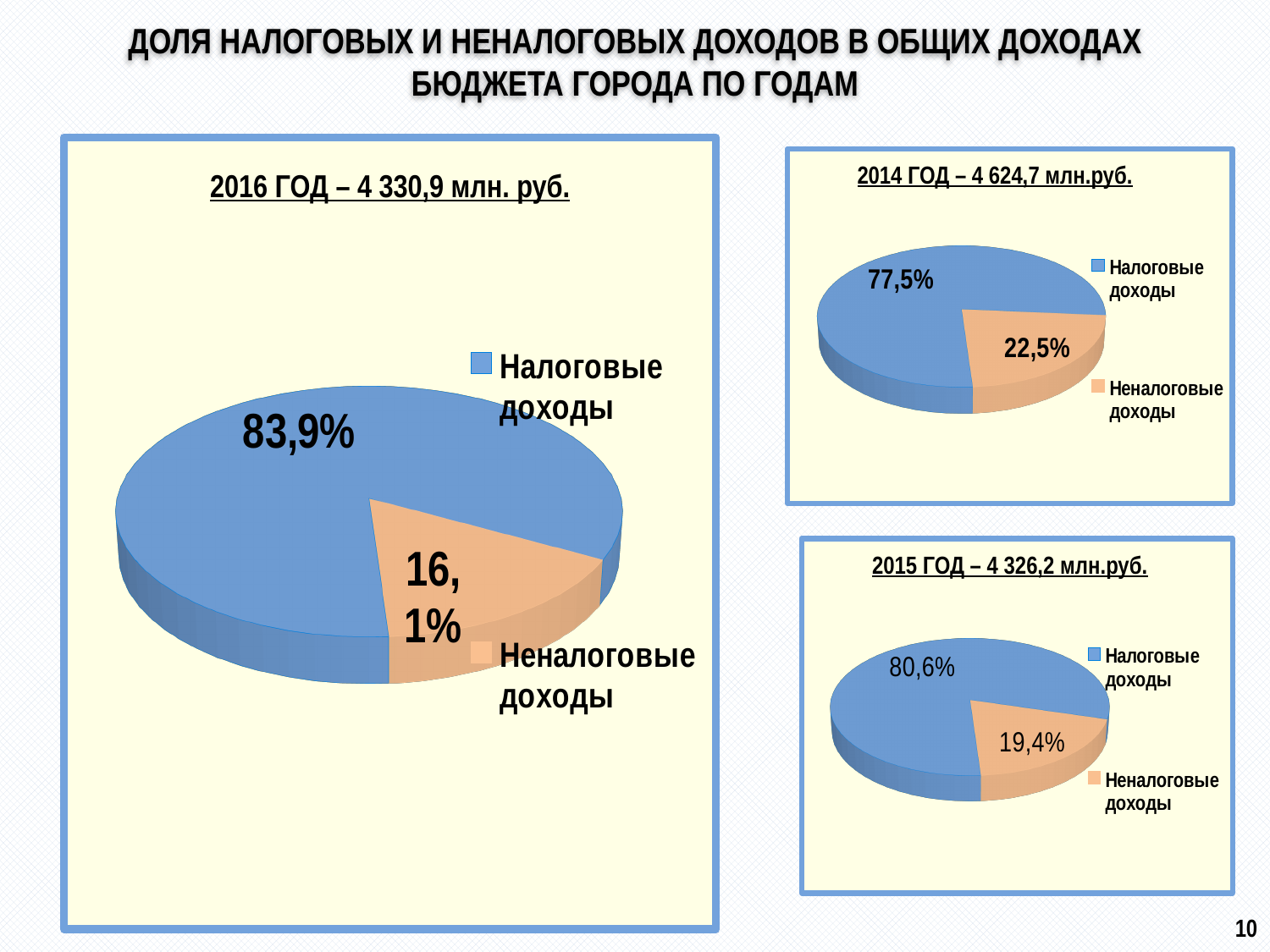
In the 2015 chart (2015 ГОД – 4 326,2 млн.руб.), what share do Налоговые доходы have? 80,6% In the 2014 chart, what share do Неналоговые доходы have? 22,5% In the 2016 chart, what share do Неналоговые доходы have? 16,1% In the 2015 chart, what is the difference in percentage points between Налоговые доходы and Неналоговые доходы? 61,2 In the 2016 chart (2016 ГОД – 4 330,9 млн. руб.), what share do Налоговые доходы have? 83,9% In the 2015 chart, what share do Неналоговые доходы have? 19,4% How many categories does the 2014 chart show? 2 In the 2016 chart, which category has the largest slice? Налоговые доходы In the 2014 chart (2014 ГОД – 4 624,7 млн.руб.), what share do Налоговые доходы have? 77,5% In the 2014 chart, which category has the smallest slice? Неналоговые доходы What type of chart is used in the 2016 chart? Pie chart What colour represents Неналоговые доходы in the 2015 chart? Orange